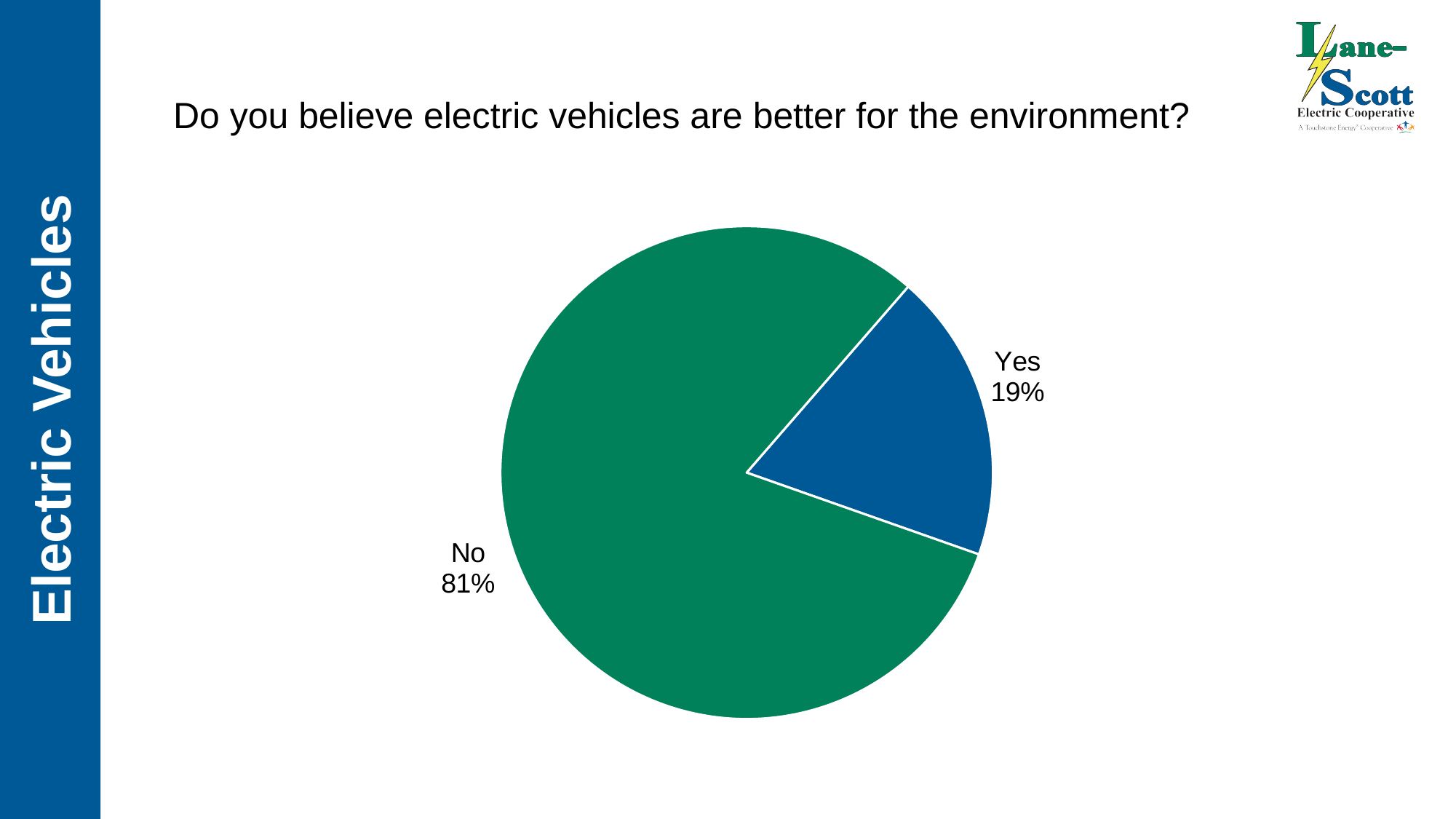
What share of the pie does the "Yes" slice represent? 19% What question does the chart title ask? Do you believe electric vehicles are better for the environment? Which slice is larger, "Yes" or "No"? No What kind of chart is shown on the slide? Pie chart How many slices does the pie chart have? 2 Which response has the smallest share of the pie? Yes What is the difference in percentage points between the "No" and "Yes" slices? 62 What percentage of respondents answered "No"? 81% Which response has the largest share of the pie? No What colour is the "No" slice? Green What percentage of respondents answered "Yes"? 19%